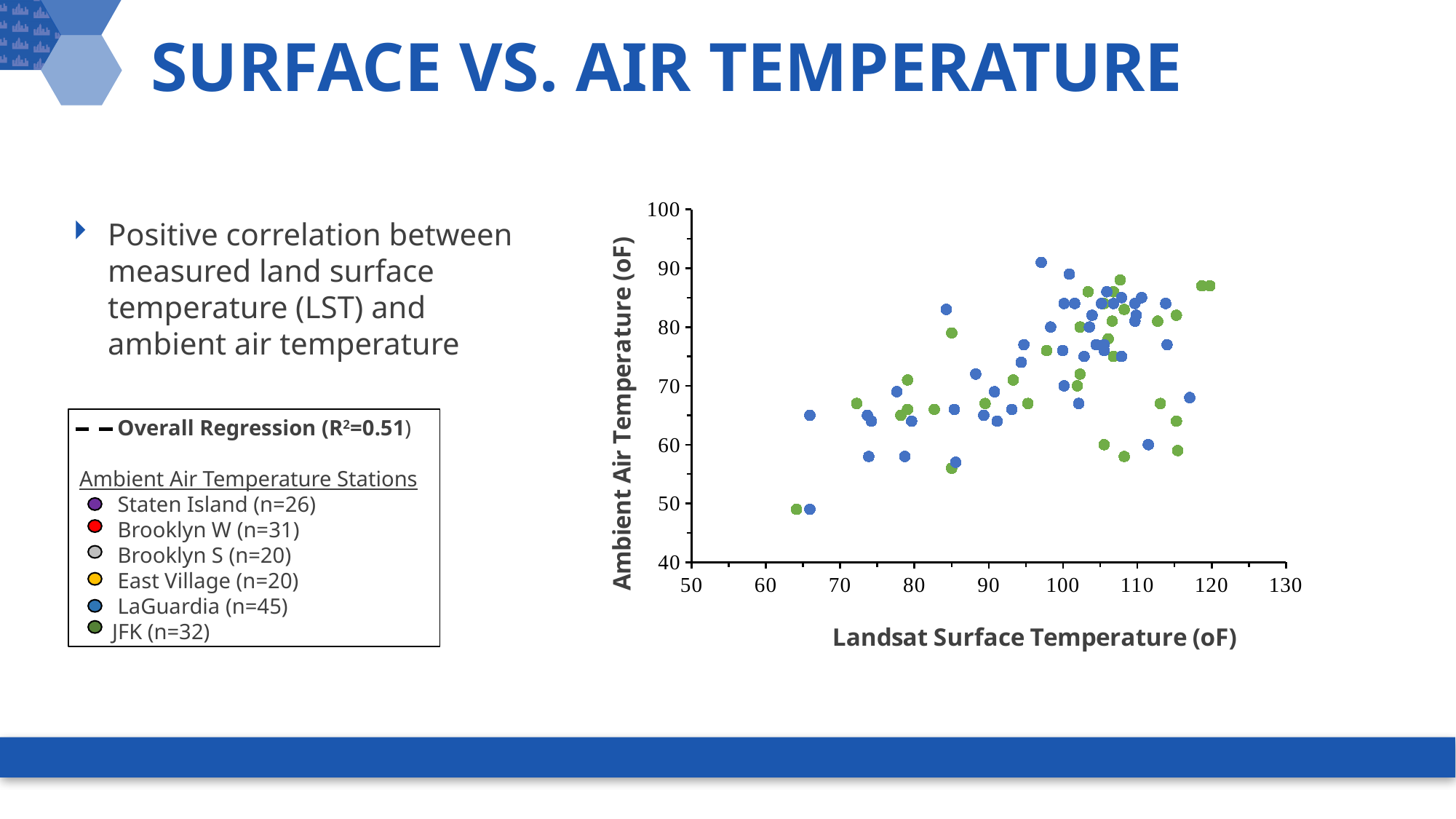
How many observations (n) does the legend give for JFK? 32 Is the lowest ambient air temperature plotted greater or less than 60? less How many ambient air temperature stations are listed in the legend? 6 Is the lowest Landsat surface temperature plotted greater or less than 70? less Is the highest Landsat surface temperature plotted greater or less than 110? greater Does ambient air temperature generally rise or fall as Landsat surface temperature increases along the x axis? Rise What is the R² value of the overall regression given in the legend? 0.51 What is the label of the x axis of the chart? Landsat Surface Temperature (oF) How many observations (n) does the legend give for LaGuardia? 45 What is the label of the y axis of the chart? Ambient Air Temperature (oF) What kind of chart is shown on the slide? Scatter plot